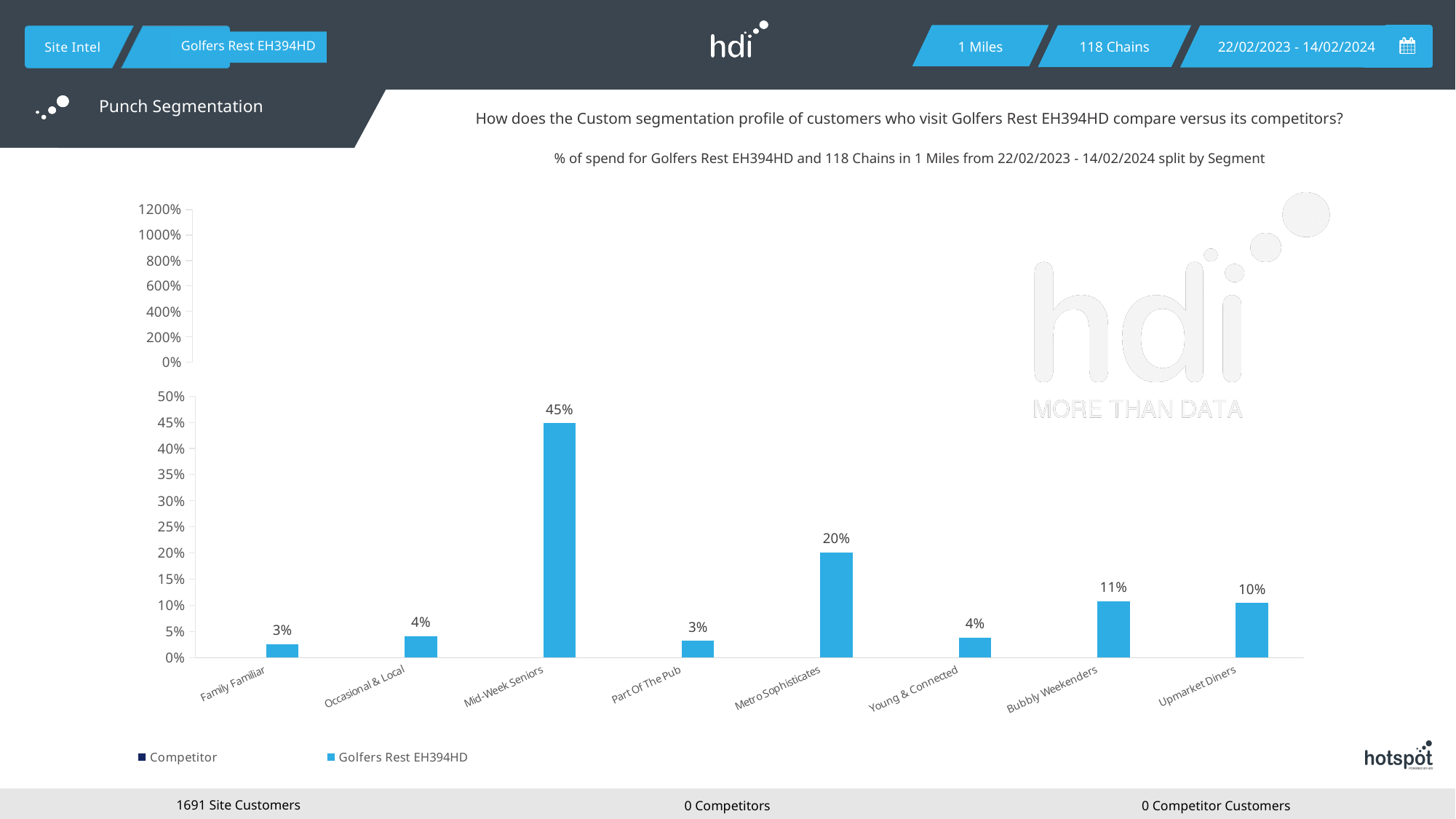
Which segment has the highest value for Golfers Rest EH394HD? Mid-Week Seniors Which is larger for Golfers Rest EH394HD: Bubbly Weekenders or Occasional & Local? Bubbly Weekenders What are the two series named in the legend? Competitor and Golfers Rest EH394HD What kind of chart is used to show the % of spend by segment? Bar chart Is the value for Metro Sophisticates greater or less than 15%? greater What is the value for Upmarket Diners for Golfers Rest EH394HD? 10% What is the value for Metro Sophisticates for Golfers Rest EH394HD? 20% What is the value for Bubbly Weekenders for Golfers Rest EH394HD? 11% What is the difference between the Mid-Week Seniors value and the Metro Sophisticates value? 25% What is the value for Mid-Week Seniors for Golfers Rest EH394HD? 45% How many segments are shown on the x axis of the chart? 8 How many series does the legend list? 2